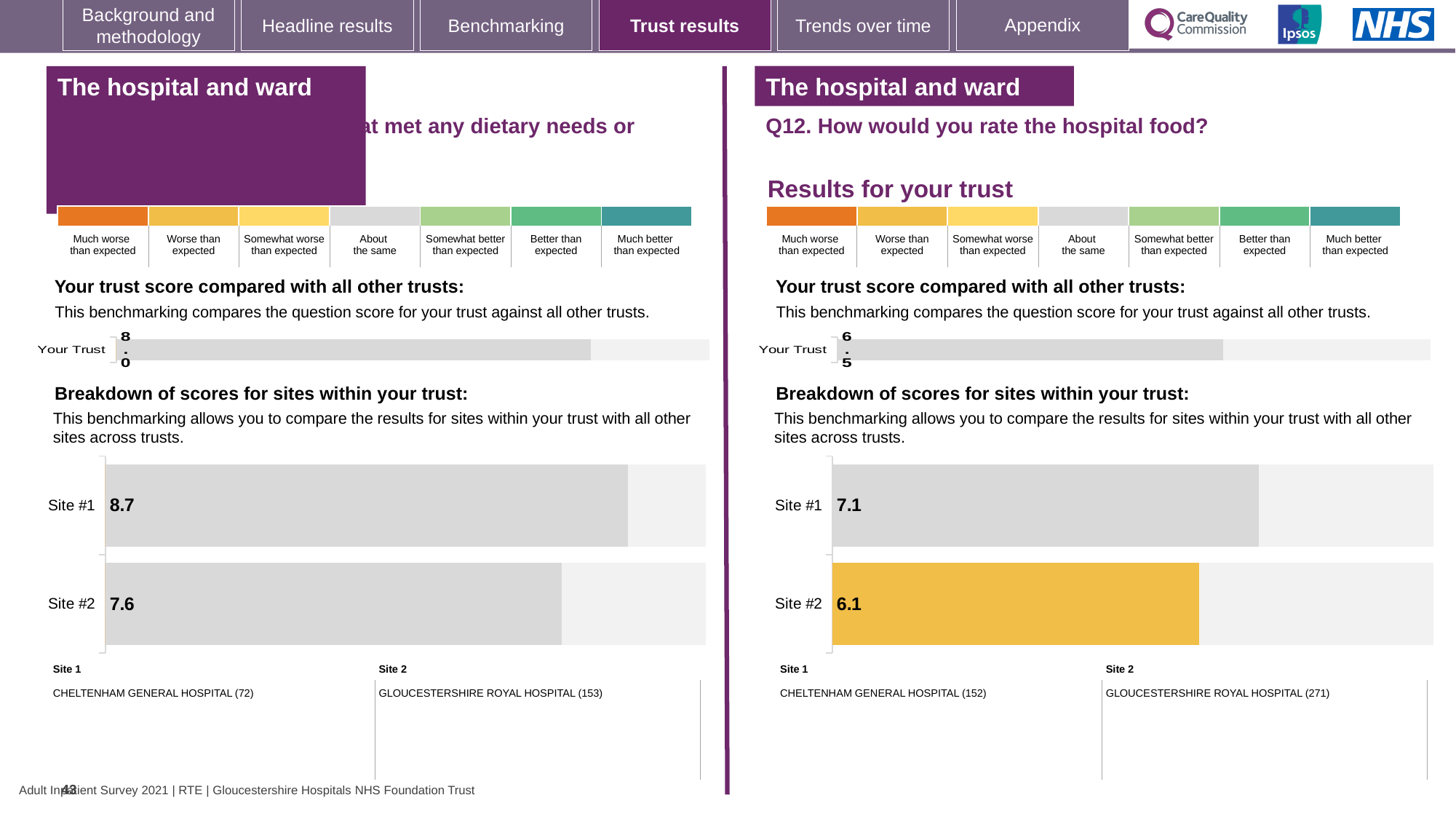
What type of chart is used for the breakdown of scores for sites on the right-hand slide (Q12)? Bar chart On the left-hand slide, which site has the lower score in the breakdown of scores for sites chart? Site #2 On the left-hand slide, what is the 'Your Trust' score shown in the trust score comparison chart? 8.0 On the right-hand slide (Q12), which site has the higher score in the breakdown of scores for sites chart? Site #1 On the right-hand slide (Q12. How would you rate the hospital food?), what is the 'Your Trust' score shown in the trust score comparison chart? 6.5 On the right-hand slide (Q12. How would you rate the hospital food?), what is the score for Site #2 in the breakdown of scores for sites chart? 6.1 On the right-hand slide (Q12. How would you rate the hospital food?), what is the score for Site #1 in the breakdown of scores for sites chart? 7.1 On the left-hand slide, what is the difference between the Site #1 and Site #2 scores? 1.1 On the left-hand slide, what is the score for Site #1 in the breakdown of scores for sites chart? 8.7 On the right-hand slide (Q12), what is the difference between the Site #1 and Site #2 scores? 1.0 On the left-hand slide, what is the score for Site #2 in the breakdown of scores for sites chart? 7.6 How many sites are shown in the breakdown of scores chart on the right-hand slide (Q12)? 2